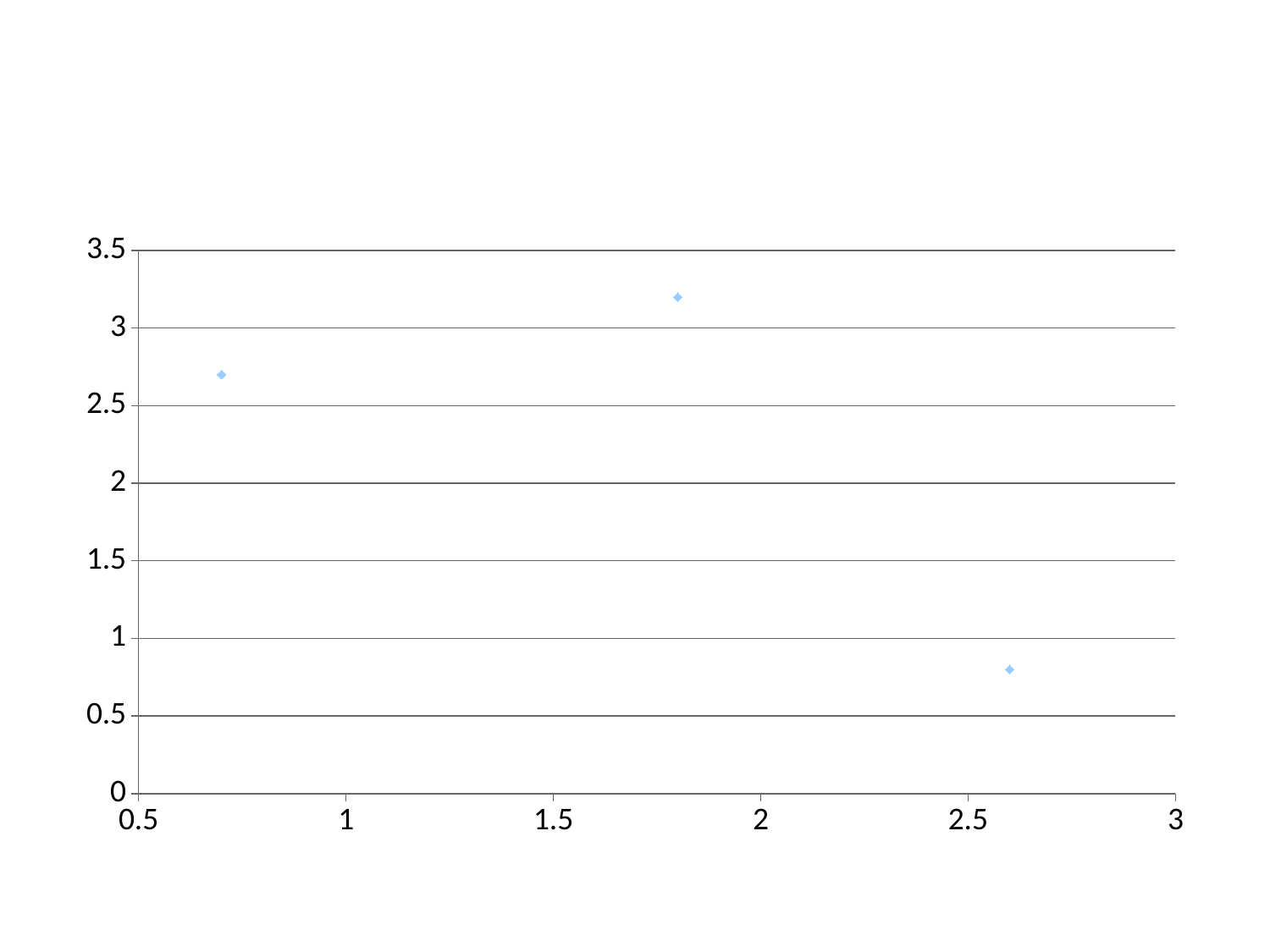
How many data points are plotted on the chart? 3 Is the y value of the leftmost point greater or less than 2.5? greater Which point has the lowest y value: the leftmost, the middle, or the rightmost? the rightmost What kind of chart is shown on the slide? scatter chart Which point has the highest y value: the leftmost, the middle, or the rightmost? the middle Is the y value of the leftmost point greater or less than 3? less Is the x value of the rightmost point greater or less than 2.5? greater What is the lowest value shown on the x axis? 0.5 Which has the larger y value, the leftmost point or the rightmost point? the leftmost point What is the highest value shown on the y axis? 3.5